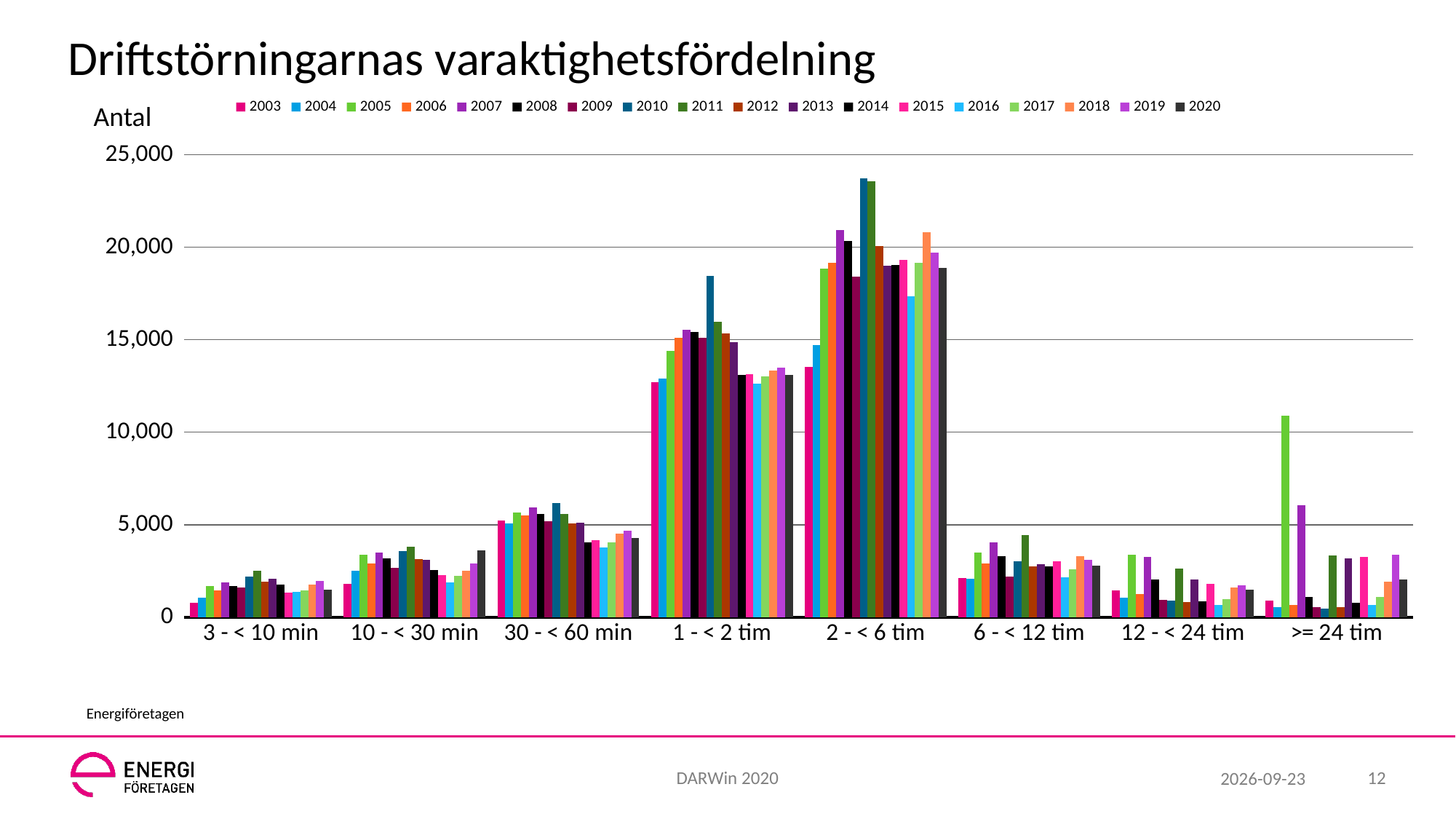
In the '1 - < 2 tim' category, which is larger, the value for 2010 or the value for 2016? 2010 Is the value for 2010 in the '1 - < 2 tim' category greater or less than 15,000? greater Which duration category has the highest values overall? 2 - < 6 tim How many duration categories are shown on the x axis? 8 In the '>= 24 tim' category, which is larger, the value for 2005 or the value for 2004? 2005 Is the value for 2005 in the '>= 24 tim' category greater or less than 10,000? greater How many series does the legend list? 18 What kind of chart is shown on the slide? bar chart What is the title of the chart? Driftstörningarnas varaktighetsfördelning Is the value for 2010 in the '2 - < 6 tim' category greater or less than 20,000? greater What label is shown on the vertical axis? Antal